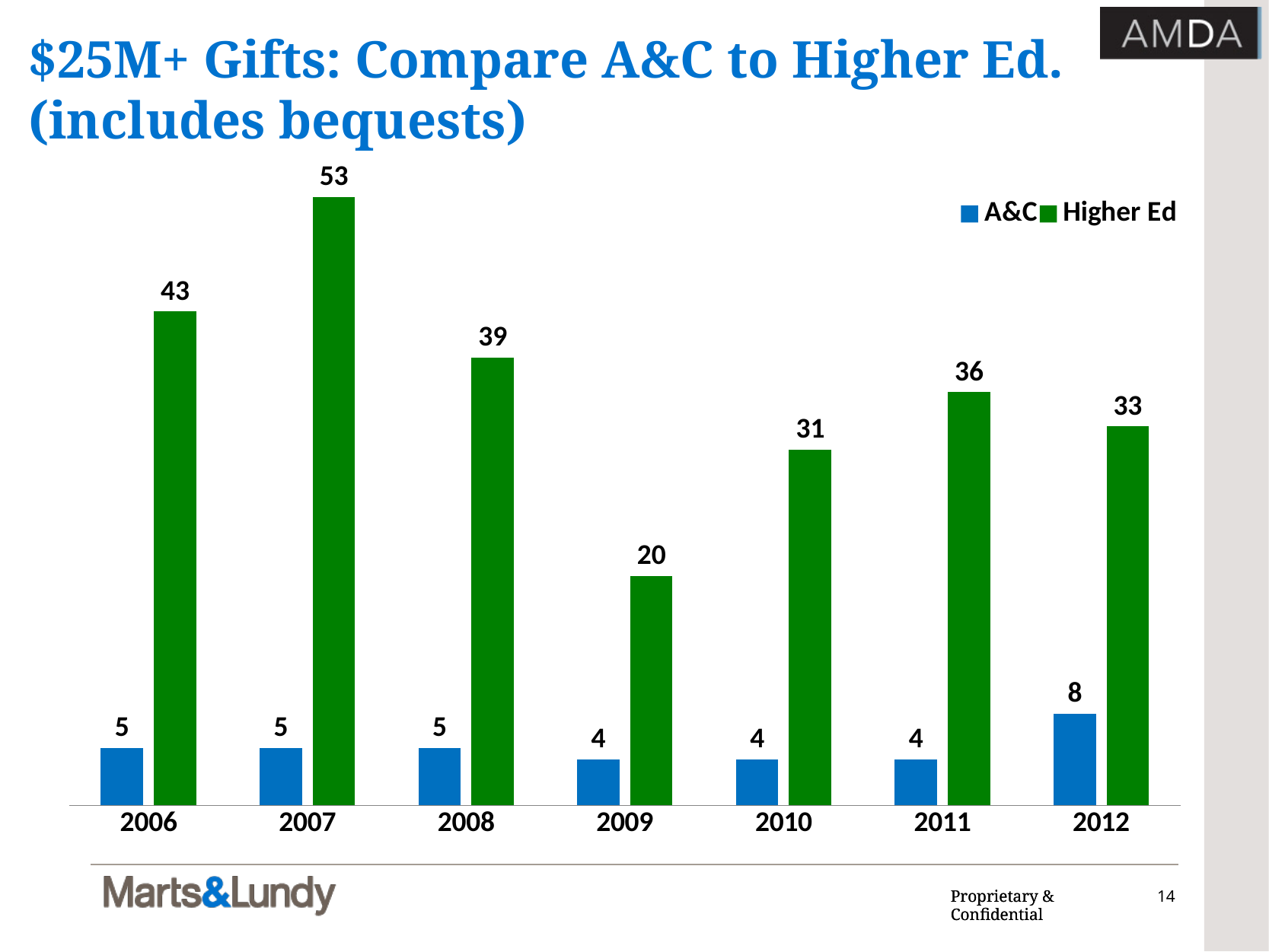
How many series does the legend list? 2 Which year has the lowest Higher Ed value? 2009 Which year has the highest A&C value? 2012 Which colour represents the Higher Ed series? Green What kind of chart is shown on the slide? Bar chart Which year has the highest Higher Ed value? 2007 What is the difference between the Higher Ed and A&C values in 2006? 38 What is the Higher Ed value for 2007? 53 What is the Higher Ed value for 2009? 20 How many years are shown on the x axis? 7 What is the A&C value for 2012? 8 Which is larger, the Higher Ed value for 2011 or for 2012? 2011